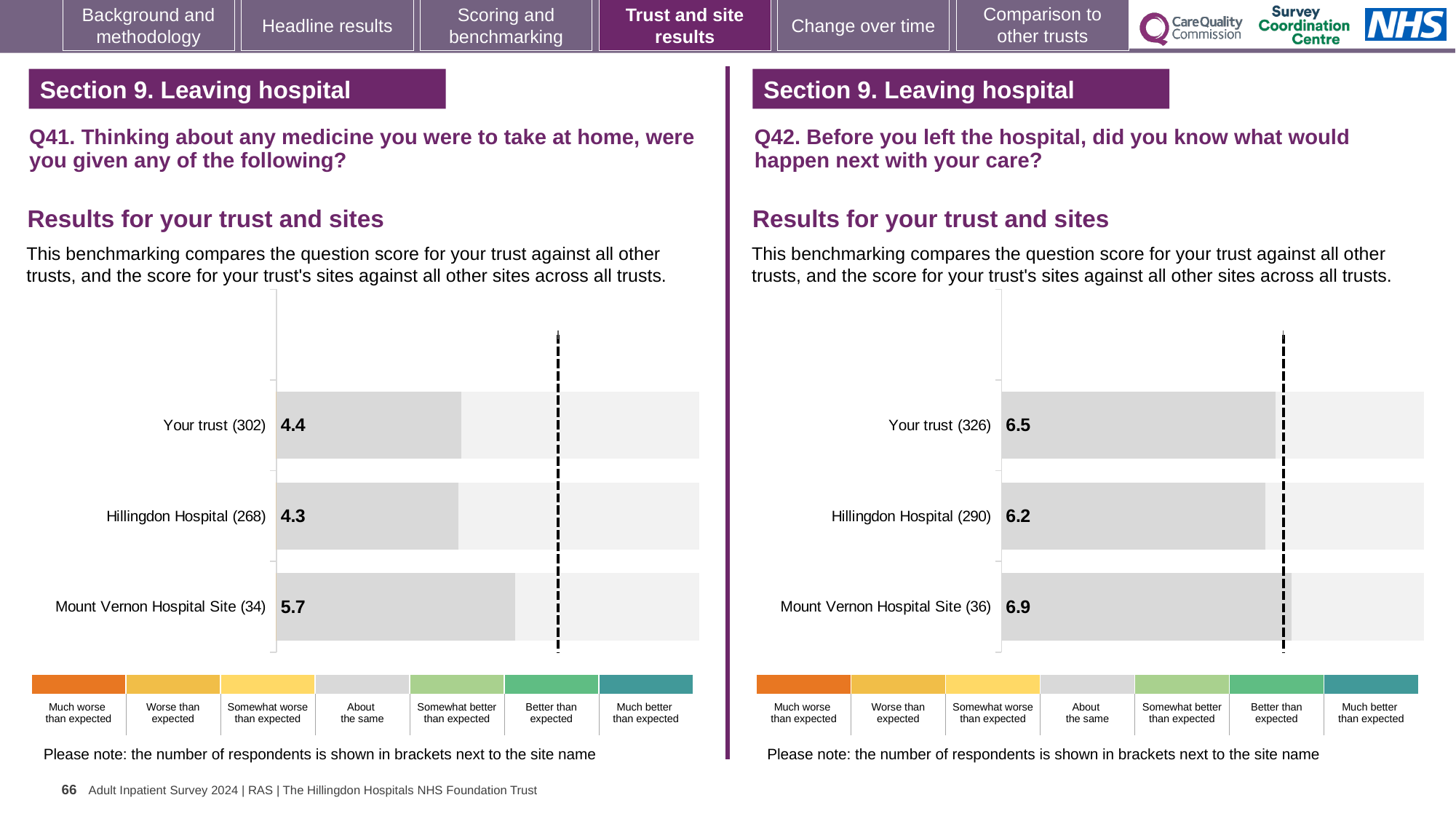
How many benchmark categories does the colour legend below the Q41 chart on the left list? 7 In the Q42 chart on the right, which site or trust has the lowest score? Hillingdon Hospital (290) In the Q42 chart on the right, which has the larger score, Your trust or Hillingdon Hospital? Your trust What kind of chart is the Q42 chart on the right? Bar chart In the Q42 chart on the right, what is the score for Hillingdon Hospital (290)? 6.2 In the Q41 chart on the left, what is the score for Mount Vernon Hospital Site (34)? 5.7 In the Q41 chart on the left, what is the score for Your trust (302)? 4.4 In the Q41 chart on the left, what is the difference between the scores for Mount Vernon Hospital Site and Hillingdon Hospital? 1.4 How many sites or trusts are plotted in the Q41 chart on the left? 3 In the Q41 chart on the left, which site or trust has the highest score? Mount Vernon Hospital Site (34) In the Q42 chart on the right, what is the difference between the scores for Mount Vernon Hospital Site and Your trust? 0.4 In the Q42 chart on the right, what is the score for Your trust (326)? 6.5